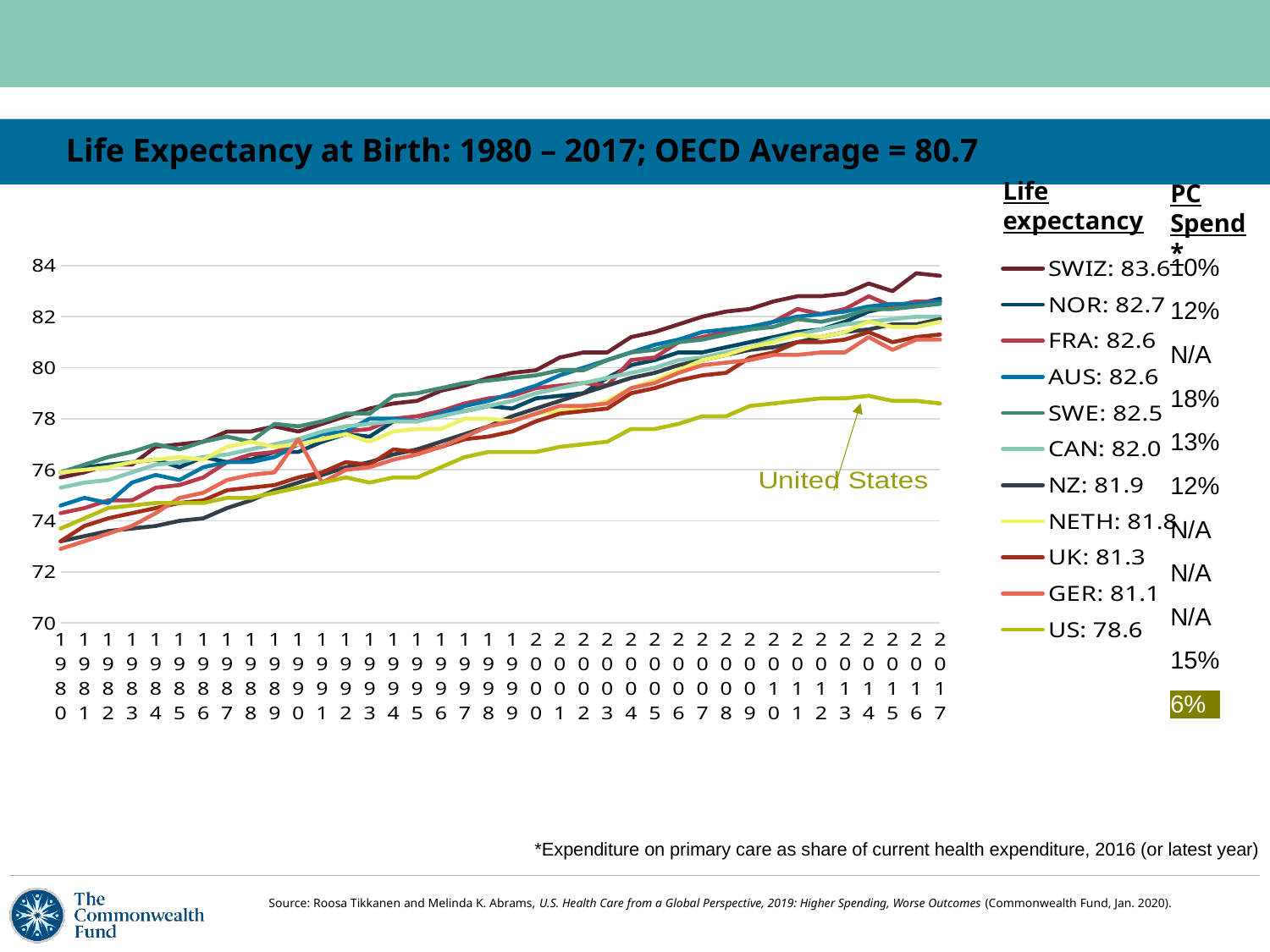
What is the difference between the legend life expectancy values for SWIZ and US? 5.0 What life expectancy value is listed in the legend for SWIZ? 83.6 What life expectancy value is listed in the legend for US? 78.6 Is the United States line in 2017 greater or less than 80? less What kind of chart is shown on the slide? line chart Which has a higher legend life expectancy value, UK or NOR? NOR Do the life expectancy lines generally rise or fall from 1980 to 2017? rise Which country has the lowest life expectancy value in the legend? US Which country has the highest life expectancy value in the legend? SWIZ How many countries (series) does the legend list? 11 What OECD average life expectancy is stated in the chart title? 80.7 What life expectancy value is listed in the legend for CAN? 82.0